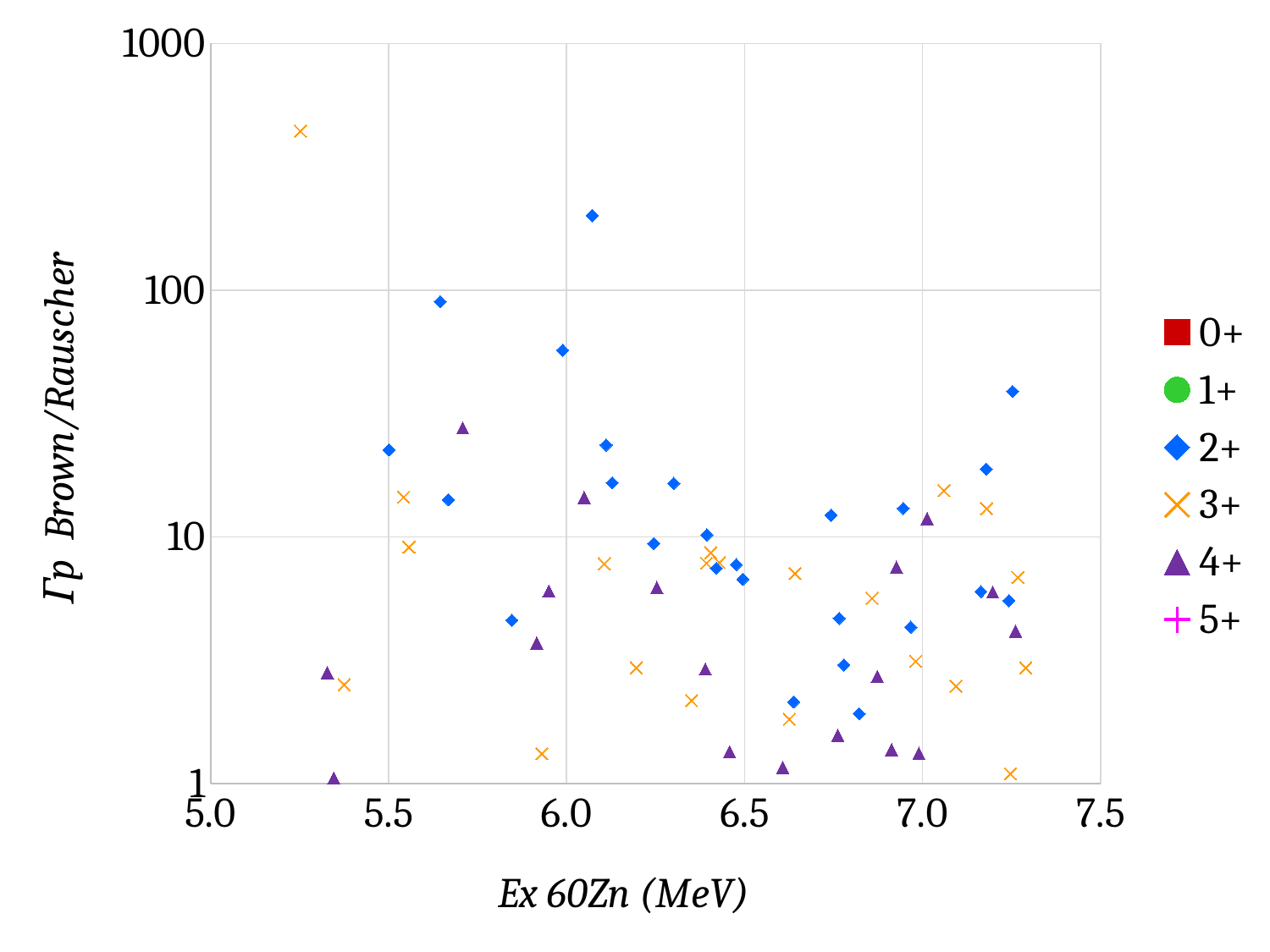
Is the highest 2+ point (near Ex 6.1 MeV) greater or less than 100? greater What kind of chart is shown on the slide? scatter chart Which series' marker is shown as an orange cross in the legend? 3+ Is the highest plotted point on the chart greater or less than 100? greater What is the label of the y axis? Γp Brown/Rauscher How many series does the legend list? 6 Which series has the highest plotted point on the chart? 3+ Which is larger: the highest 2+ point or the highest 4+ point? the highest 2+ point Is the 3+ point near Ex 7.25 MeV at the bottom of the chart greater or less than 10? less What is the label of the x axis? Ex 60Zn (MeV)